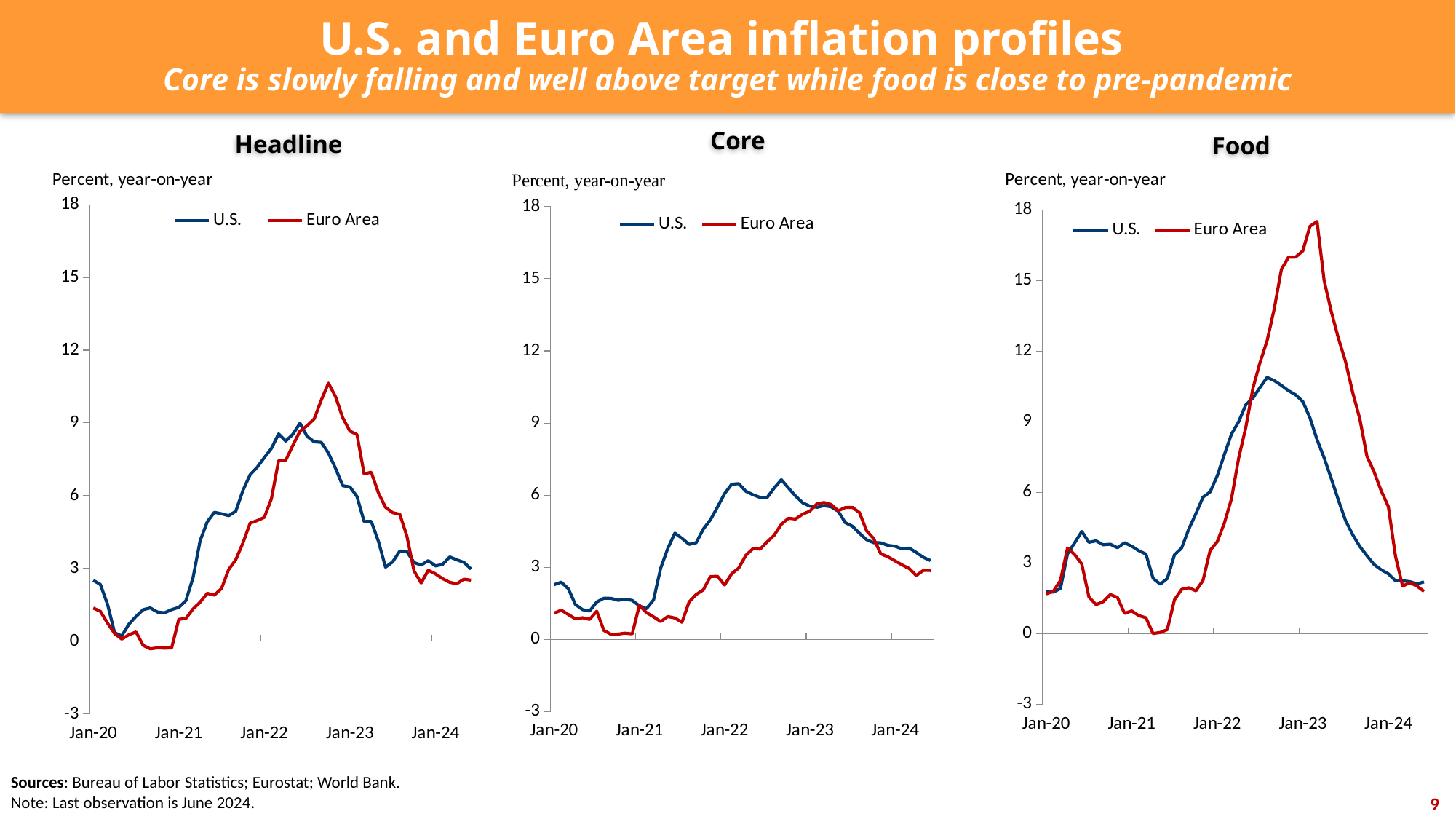
In the Food chart, does the Euro Area line rise or fall between Jan-23 and Jan-24? fall What is the y-axis label shown above the Food chart? Percent, year-on-year How many charts are shown on the slide? 3 In the Headline chart, is the Euro Area value at Jan-21 greater or less than 3? less In the Headline chart, which series reaches the higher peak, U.S. or Euro Area? Euro Area What kind of chart is the Headline chart? line chart In the Food chart, is the peak value of the Euro Area line greater or less than 15? greater In the Core chart, does the Euro Area line rise or fall between Jan-21 and Jan-23? rise In the Food chart, which series reaches the higher peak, U.S. or Euro Area? Euro Area In the Headline chart, is the peak value of the U.S. line greater or less than 12? less How many series does the legend of the Core chart list? 2